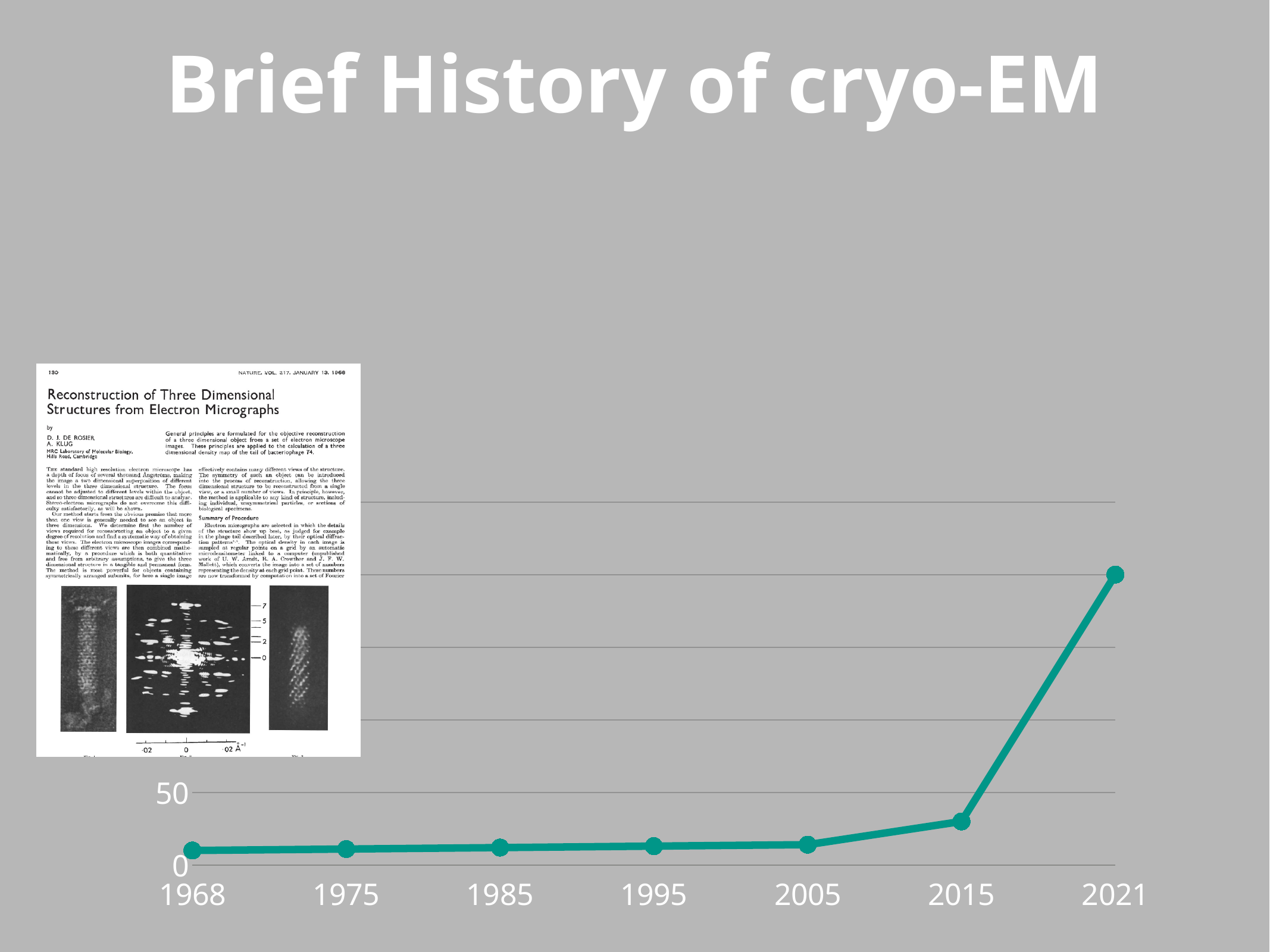
Is the value for 2021 greater or less than 50? greater Which is larger, the value for 2021 or the value for 2015? 2021 Do the values on the line chart rise or fall from 1968 to 2021? rise Which year has the highest value on the line chart? 2021 What kind of chart is shown on the slide? line chart How many data points are plotted on the line chart? 7 Is the value for 1968 greater or less than 50? less Is the value for 2015 greater or less than 50? less Which is larger, the value for 2015 or the value for 2005? 2015 What is the title of the slide containing the chart? Brief History of cryo-EM What is the first year shown on the x axis of the chart? 1968